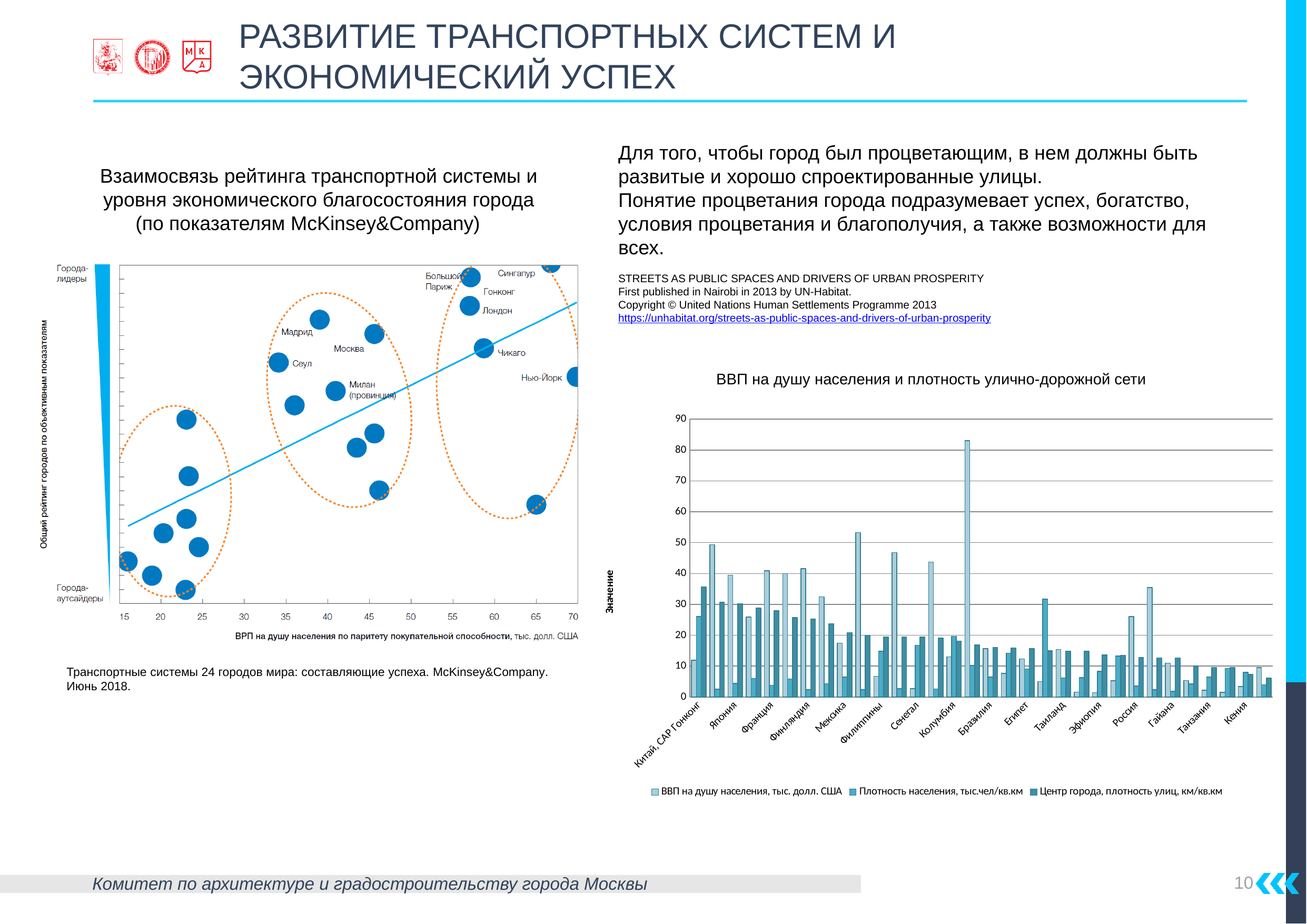
What kind of chart is the chart on the left titled 'Взаимосвязь рейтинга транспортной системы и уровня экономического благосостояния города'? scatter chart In the scatter chart on the left, which city has the larger ВРП на душу населения, Нью-Йорк or Сеул? Нью-Йорк In the scatter chart on the left, is the x-axis value (ВРП на душу населения) for Нью-Йорк greater or less than 65? greater In the scatter chart on the left, does the trend line rise or fall as ВРП на душу населения increases? rises In the chart 'ВВП на душу населения и плотность улично-дорожной сети', is the tallest bar greater or less than 70? greater In the chart 'ВВП на душу населения и плотность улично-дорожной сети', which series contains the tallest bar? ВВП на душу населения, тыс. долл. США What kind of chart is the chart on the right titled 'ВВП на душу населения и плотность улично-дорожной сети'? bar chart In the chart 'ВВП на душу населения и плотность улично-дорожной сети', is the value of 'ВВП на душу населения, тыс. долл. США' for Китай, САР Гонконг greater or less than 20? less In the scatter chart on the left, how many dotted ellipses group the cities? 3 In the chart 'ВВП на душу населения и плотность улично-дорожной сети', how many series does the legend list? 3